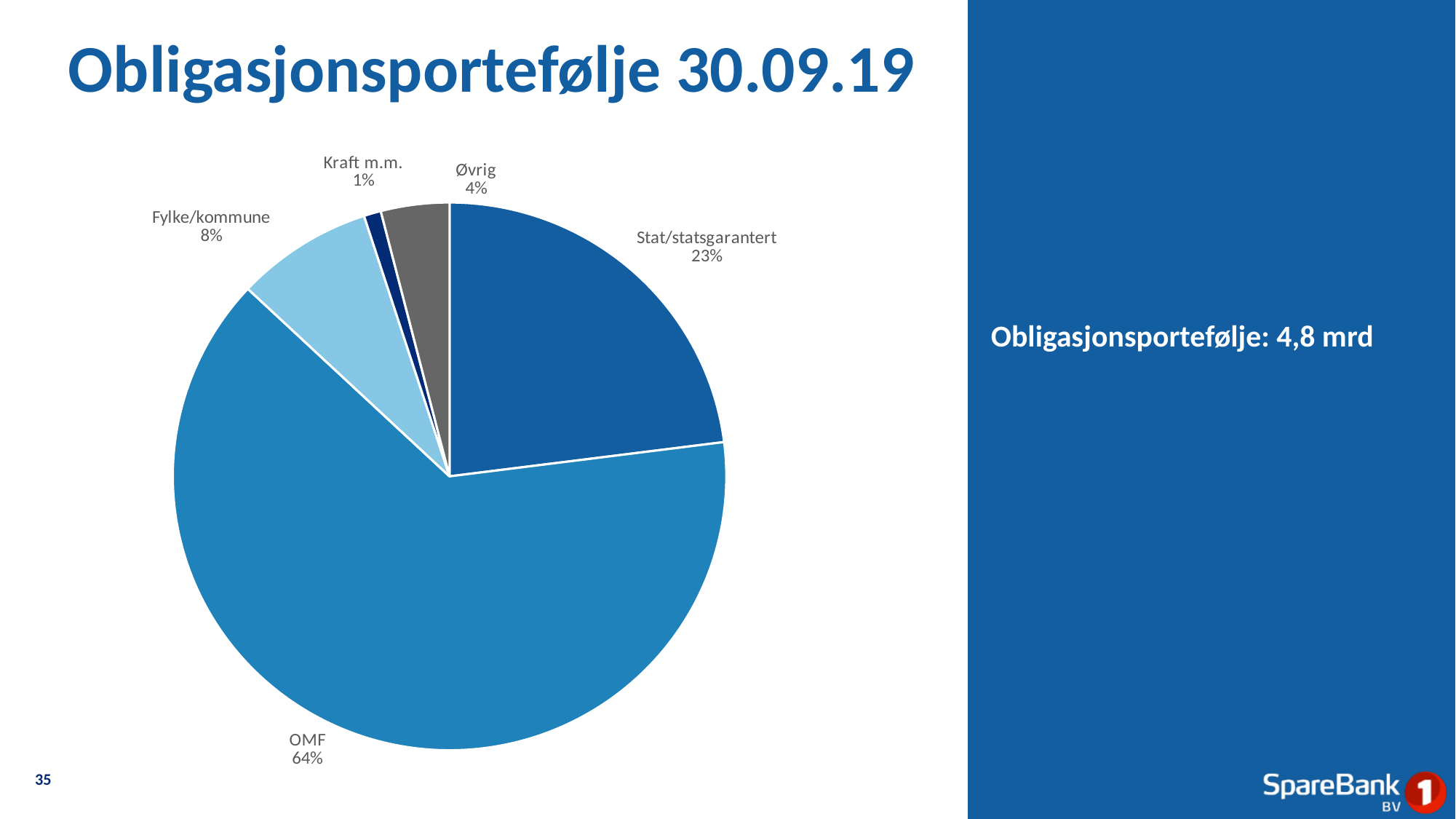
How many categories are shown in the pie chart? 5 Which category has the largest slice of the pie? OMF What share of the pie does Øvrig represent? 4% What is the title of the slide containing the chart? Obligasjonsportefølje 30.09.19 What share of the pie does Fylke/kommune represent? 8% What share of the pie does Kraft m.m. represent? 1% What is the difference in percentage points between OMF and Stat/statsgarantert? 41 What kind of chart is shown on the slide? Pie chart Which category has the smallest slice of the pie? Kraft m.m. Which is larger, the share for Fylke/kommune or the share for Øvrig? Fylke/kommune